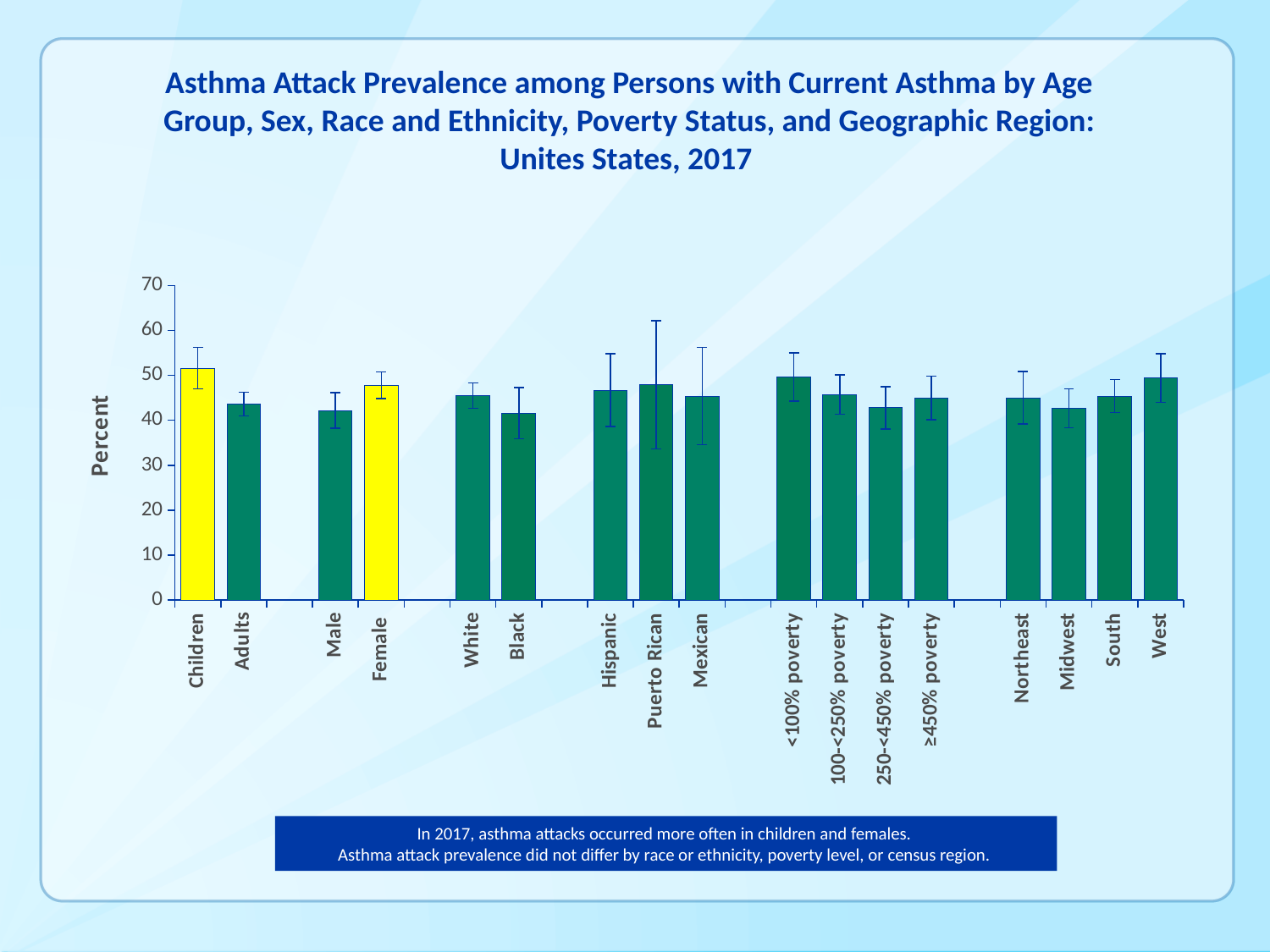
What is the label of the vertical axis? Percent Which has the higher asthma attack prevalence, Male or Female? Female Is the value for Black greater or less than 50? less Is the value for Children greater or less than 40? greater Which has the higher asthma attack prevalence, Children or Adults? Children Which two bars are highlighted in yellow? Children and Female What kind of chart is shown on the slide? bar chart How many bars (categories) are plotted in the chart? 17 Is the value for Male greater or less than 50? less Which has the higher asthma attack prevalence, West or Midwest? West